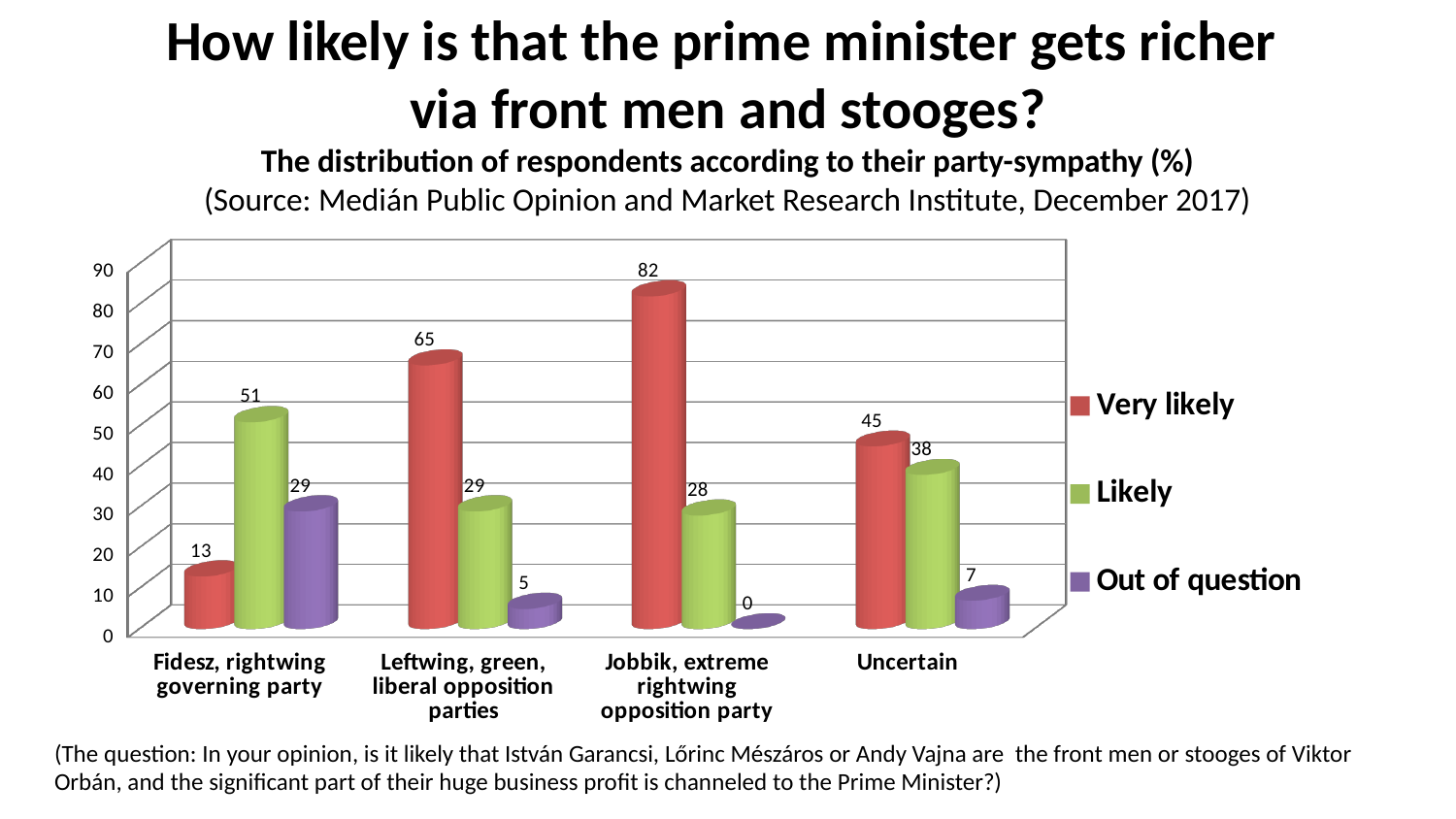
What is the 'Likely' value for Fidesz, rightwing governing party? 51 How many series does the legend list? 3 Which is larger for Uncertain: the 'Very likely' value or the 'Likely' value? Very likely What is the 'Out of question' value for Uncertain? 7 What kind of chart is shown on the slide? Bar chart How many party-sympathy categories are shown on the x axis? 4 What is the 'Very likely' value for Jobbik, extreme rightwing opposition party? 82 What is the difference between the 'Very likely' values for Leftwing, green, liberal opposition parties and Fidesz, rightwing governing party? 52 Which category has the highest 'Very likely' value? Jobbik, extreme rightwing opposition party Which colour represents the 'Out of question' series? Purple Which category has the lowest 'Out of question' value? Jobbik, extreme rightwing opposition party What is the 'Out of question' value for Leftwing, green, liberal opposition parties? 5